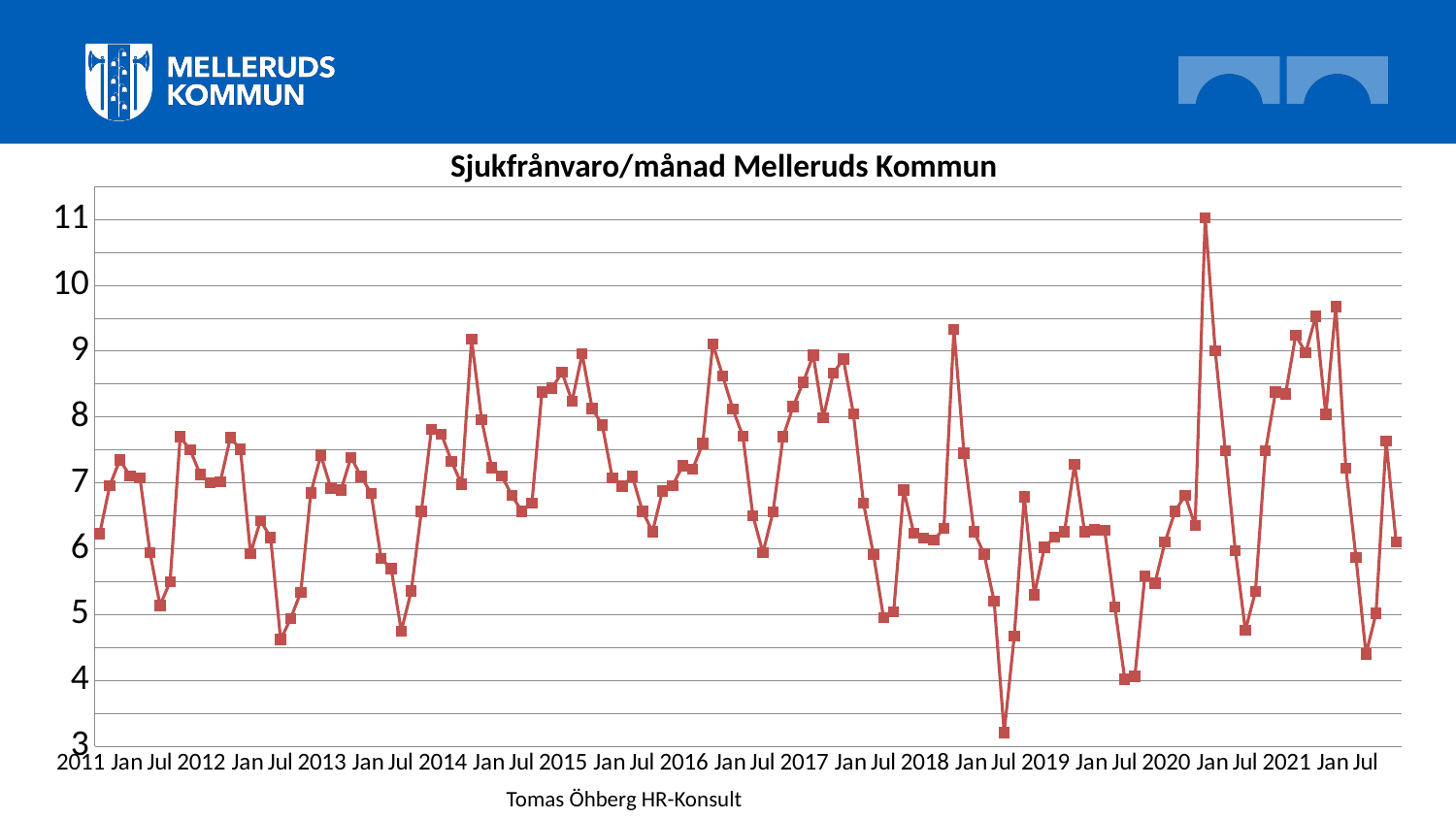
What is the title of the chart? Sjukfrånvaro/månad Melleruds Kommun Around which x-axis label does the line reach its highest point? Jan 2020 What is the lowest value shown on the y axis? 3 Is the highest value on the line greater or less than 10? greater Around which x-axis label does the line reach its lowest point? Jul 2018 Is the value at Jan 2019 greater or less than 7? less What kind of chart is shown on the slide? line chart Is the value at Jan 2015 greater or less than 8? greater Does the line rise or fall between Jul 2019 and Jan 2020? rise Which is larger, the value at Jan 2020 or the value at Jan 2019? Jan 2020